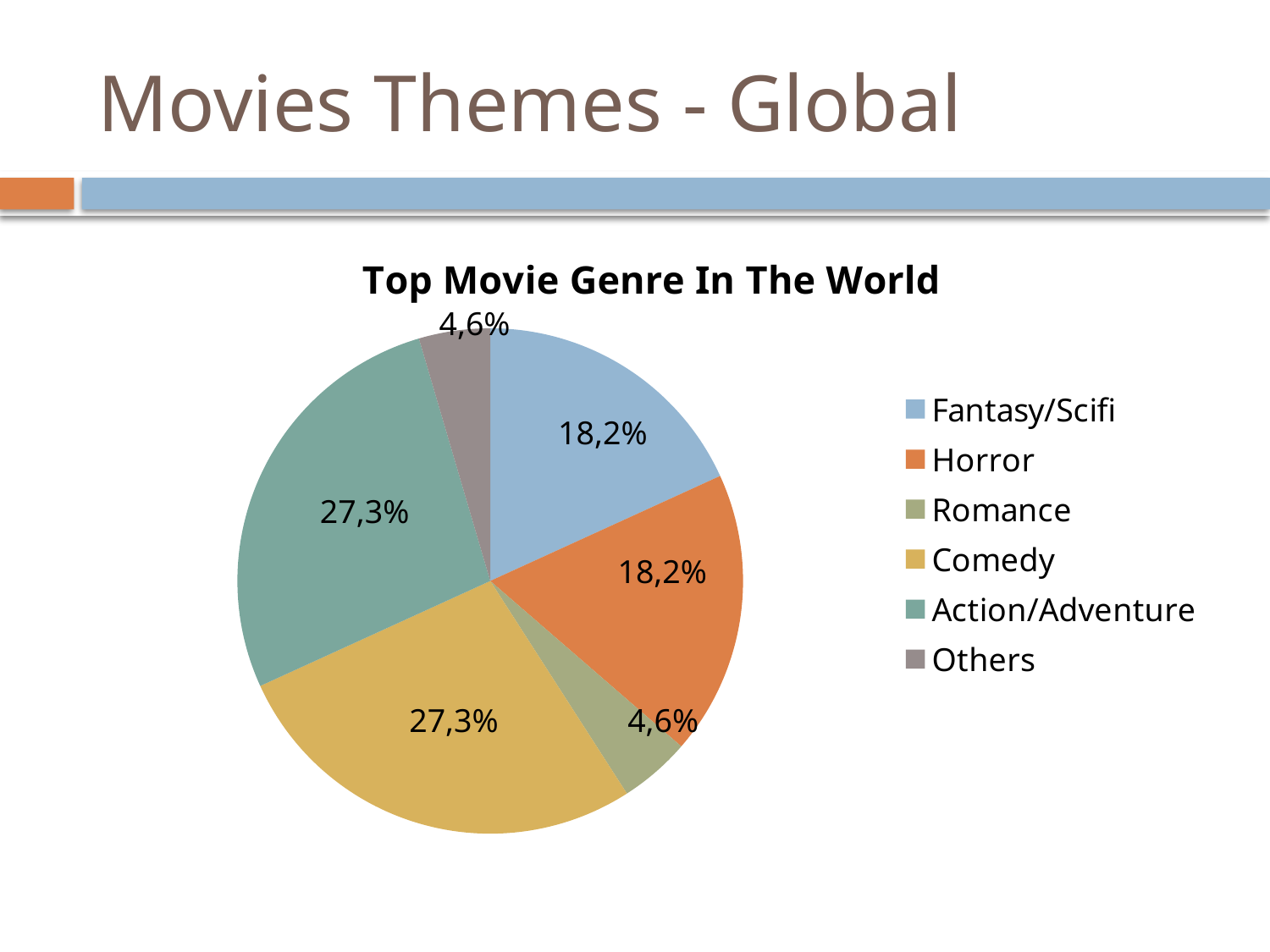
How many genres are shown in the pie chart? 6 What is the value shown for Horror? 18,2% What share of the pie does Comedy have? 27,3% What is the difference between the Fantasy/Scifi and Others shares? 13,6% What kind of chart is shown on the slide? Pie chart What percentage is shown for Romance? 4,6% What is the value for Action/Adventure? 27,3% What is the difference between the Comedy and Horror shares? 9,1% Which is larger, Comedy or Horror? Comedy What share does the Others slice have? 4,6% Which is larger, Fantasy/Scifi or Romance? Fantasy/Scifi What is the title of the chart? Top Movie Genre In The World